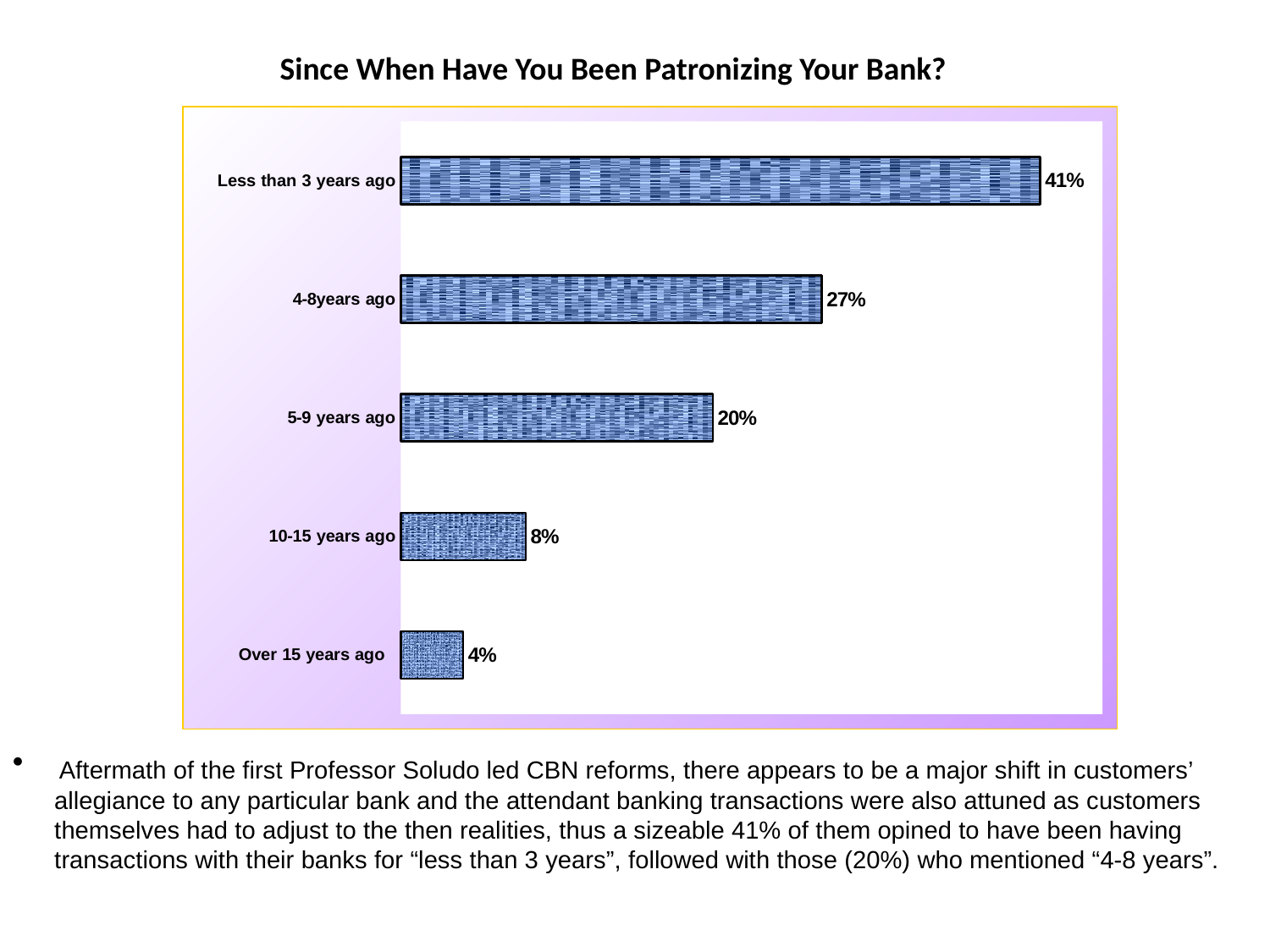
What is the value shown for '4-8years ago'? 27% Which is larger, the value for '5-9 years ago' or the value for 'Over 15 years ago'? 5-9 years ago What is the title of the chart? Since When Have You Been Patronizing Your Bank? How many categories are shown in the chart? 5 Which category has the highest value? Less than 3 years ago Which category has the lowest value? Over 15 years ago What is the difference between the values for 'Less than 3 years ago' and '4-8years ago'? 14% What is the difference between the values for '5-9 years ago' and '10-15 years ago'? 12% What kind of chart is shown on the slide? Bar chart What is the value shown for 'Over 15 years ago'? 4% What is the value shown for '10-15 years ago'? 8% What percentage of respondents have been patronizing their bank for less than 3 years? 41%